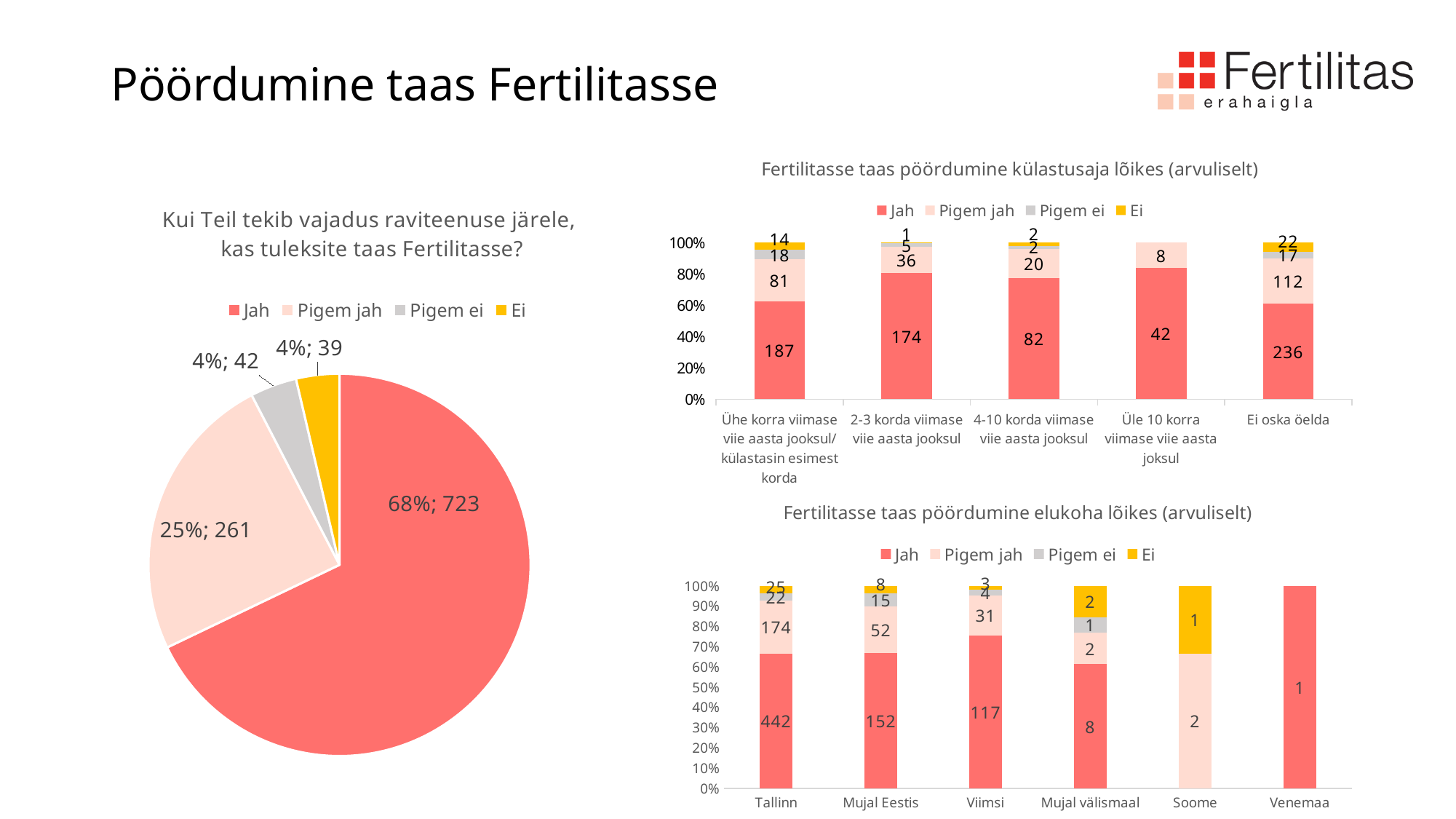
What kind of chart is the chart on the left of the slide? Pie chart In the chart 'Fertilitasse taas pöördumine elukoha lõikes (arvuliselt)', what is the total of the stacked bar for 'Tallinn'? 663 In the chart 'Fertilitasse taas pöördumine külastusaja lõikes (arvuliselt)', which category has the highest 'Jah' value? Ei oska öelda In the chart 'Fertilitasse taas pöördumine elukoha lõikes (arvuliselt)', which is larger: the 'Jah' value for 'Viimsi' or for 'Mujal Eestis'? Mujal Eestis In the pie chart, what share of the pie does 'Pigem jah' take? 25% In the chart 'Fertilitasse taas pöördumine külastusaja lõikes (arvuliselt)', how many series does the legend list? 4 In the pie chart, what value is shown for the 'Jah' slice? 68%; 723 In the chart 'Fertilitasse taas pöördumine külastusaja lõikes (arvuliselt)', what is the difference between the 'Jah' values for 'Ühe korra viimase viie aasta jooksul/külastasin esimest korda' and '2-3 korda viimase viie aasta jooksul'? 13 In the chart 'Fertilitasse taas pöördumine külastusaja lõikes (arvuliselt)', what is the 'Jah' value for 'Ei oska öelda'? 236 In the pie chart, how many respondents answered 'Ei'? 39 In the chart 'Fertilitasse taas pöördumine elukoha lõikes (arvuliselt)', what is the 'Pigem jah' value for 'Mujal Eestis'? 52 In the chart 'Fertilitasse taas pöördumine elukoha lõikes (arvuliselt)', how many categories are shown on the x axis? 6